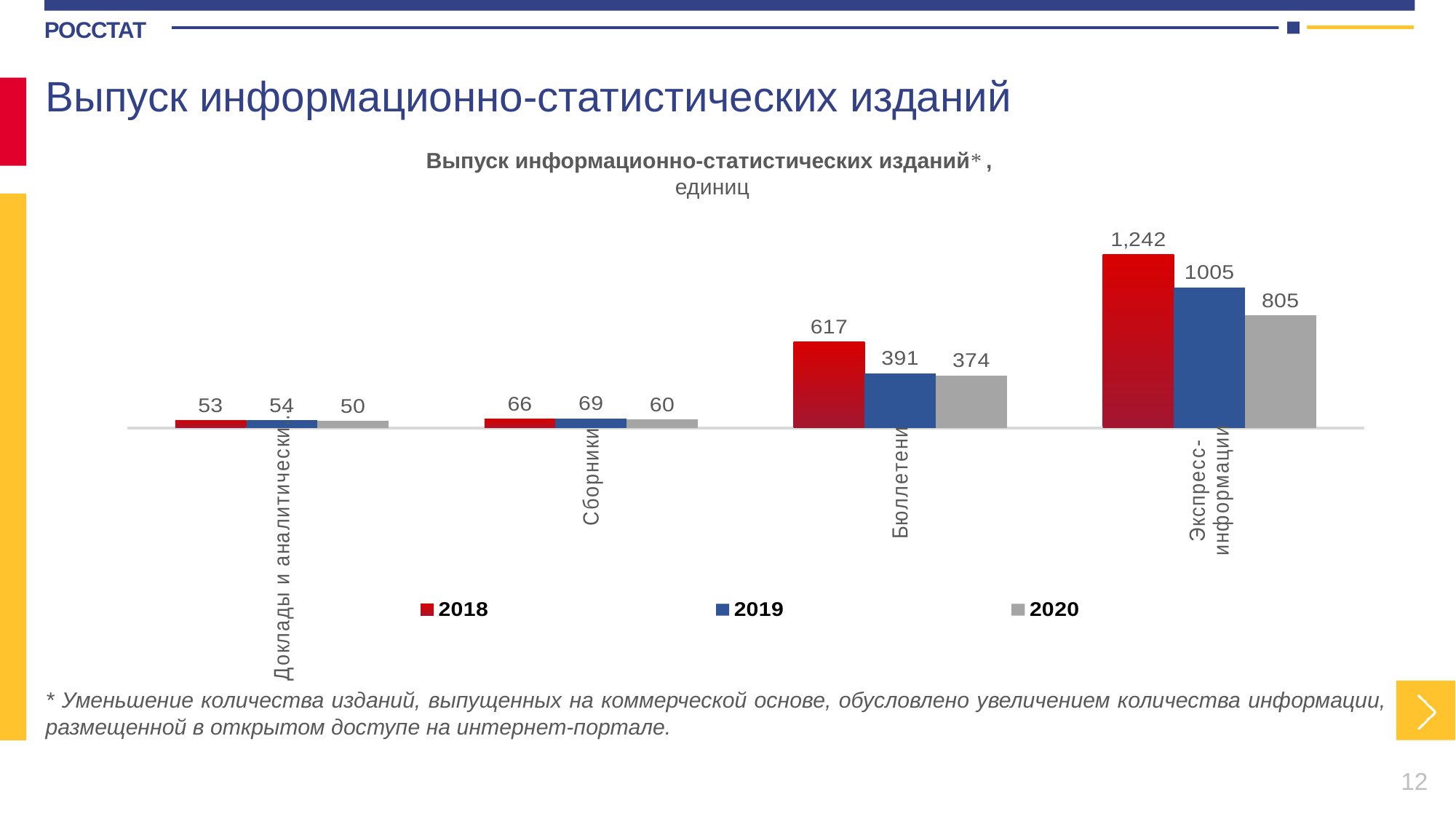
How many categories are shown on the x axis? 4 How many series does the legend list? 3 What is the value for Сборники in 2019? 69 Which category has the lowest value in 2018? Доклады и аналитические Which category has the highest value in 2020? Экспресс-информации What is the difference between the 2018 and 2019 values for Бюллетени? 226 What kind of chart is shown on the slide? bar chart Which is larger for Сборники: the 2019 value or the 2020 value? 2019 What is the difference between the 2019 and 2020 values for Экспресс-информации? 200 What is the value for Бюллетени in 2020? 374 What is the value for Экспресс-информации in 2018? 1,242 Do the values for Экспресс-информации rise or fall from 2018 to 2020? fall